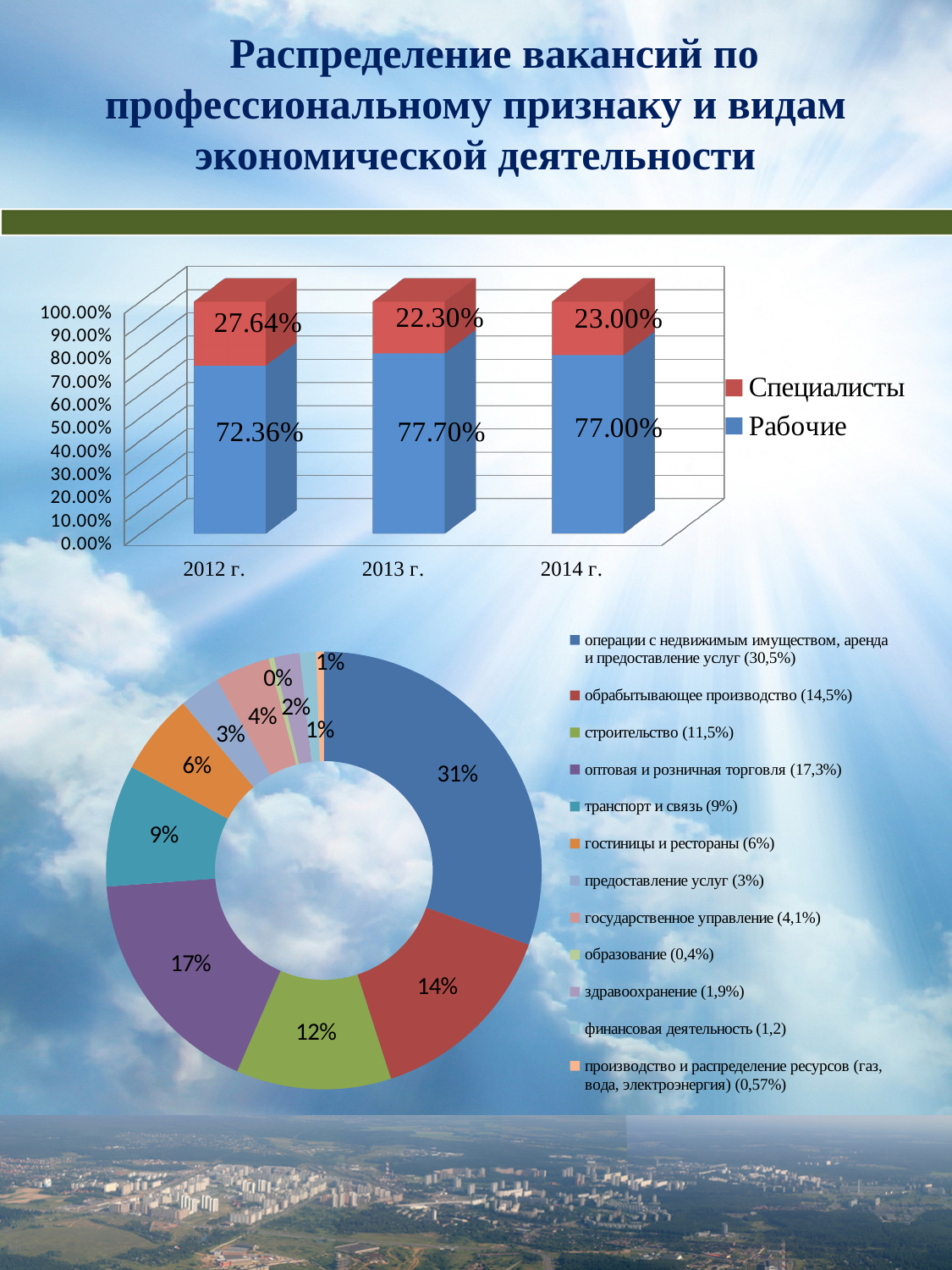
How many years are shown on the x axis of the top bar chart? 3 In the top bar chart, what is the value for Специалисты in 2014 г.? 23.00% How many categories does the legend of the bottom doughnut chart list? 12 How many series does the legend of the top bar chart list? 2 In the bottom doughnut chart, which category has the largest slice? операции с недвижимым имуществом, аренда и предоставление услуг In the bottom doughnut chart, which slice is larger: транспорт и связь or гостиницы и рестораны? транспорт и связь What kind of chart is the top chart on the slide? Stacked bar chart In the top bar chart, which year has the highest share of Специалисты? 2012 г. In the bottom doughnut chart, what percentage label is shown for the строительство slice? 12% In the top bar chart, what is the value for Рабочие in 2012 г.? 72.36% What kind of chart is the bottom chart on the slide? Doughnut (pie) chart In the top bar chart, what is the difference between the Рабочие value in 2013 г. and in 2012 г.? 5.34%